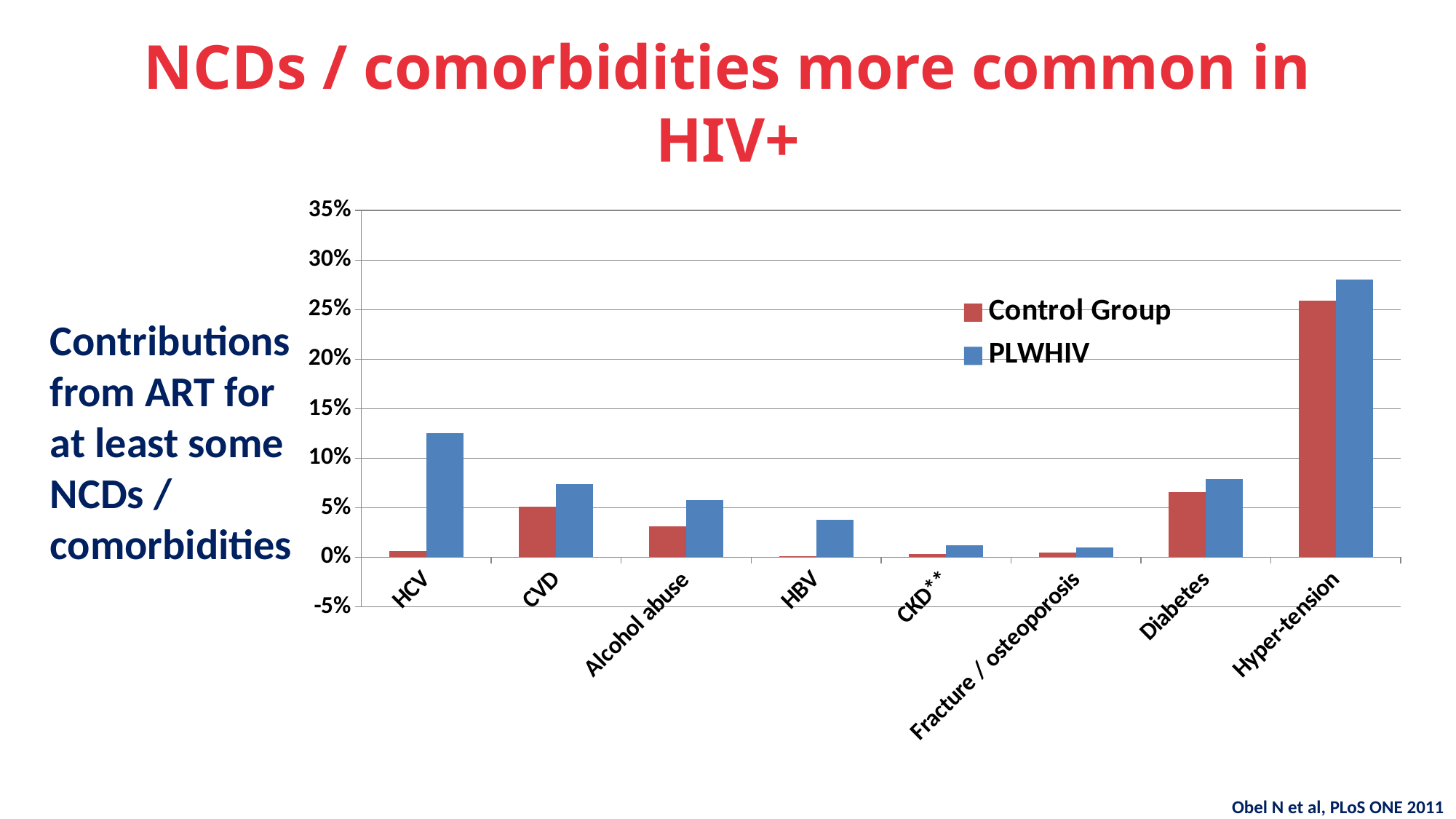
Is the PLWHIV value for HBV greater or less than 5%? less What are the two series named in the legend? Control Group and PLWHIV How many categories are shown on the x axis? 8 Is the PLWHIV value for Hyper-tension greater or less than 25%? greater Is the PLWHIV value for HCV greater or less than 10%? greater For HCV, which series has the larger value, Control Group or PLWHIV? PLWHIV How many series does the legend list? 2 What kind of chart is shown on the slide? bar chart Which category has the highest value for the Control Group? Hyper-tension For Alcohol abuse, which series has the larger value, Control Group or PLWHIV? PLWHIV Which category has the highest value for PLWHIV? Hyper-tension